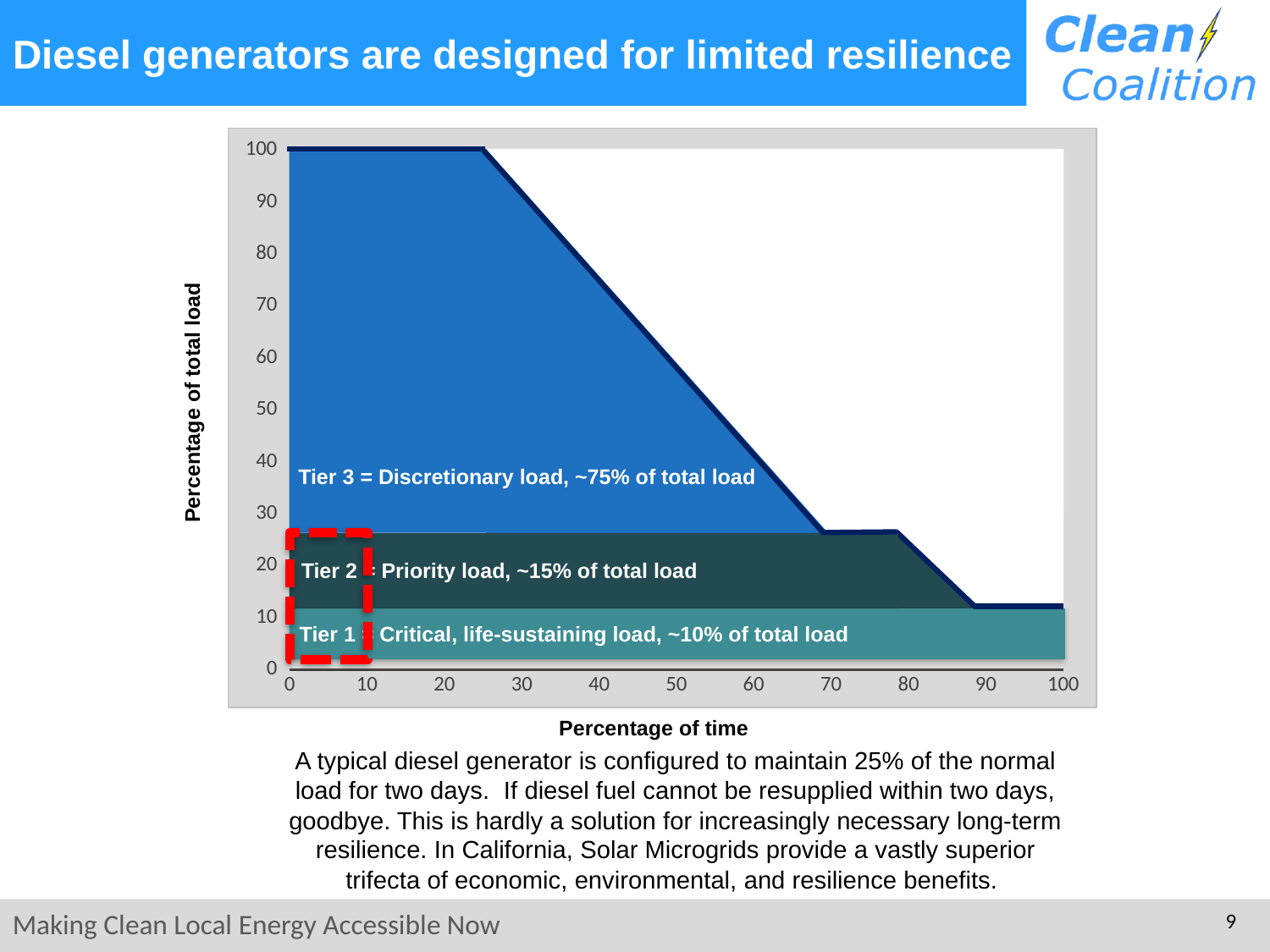
Is the percentage of total load at 50% of time greater or less than 40? greater Is the percentage of total load at 60% of time greater or less than 30? greater Is the percentage of total load at 100% of time greater or less than 20? less What is the percentage of total load at 0% of time? 100 What kind of chart is shown on the slide? area chart What is the title of the y axis of the chart? Percentage of total load How many tiers of load are labelled on the chart? 3 Do the values rise or fall as the percentage of time increases along the x axis? fall Which is larger, the percentage of total load at 20% of time or at 90% of time? 20% of time What is the title of the x axis of the chart? Percentage of time What is the percentage of total load at 10% of time? 100